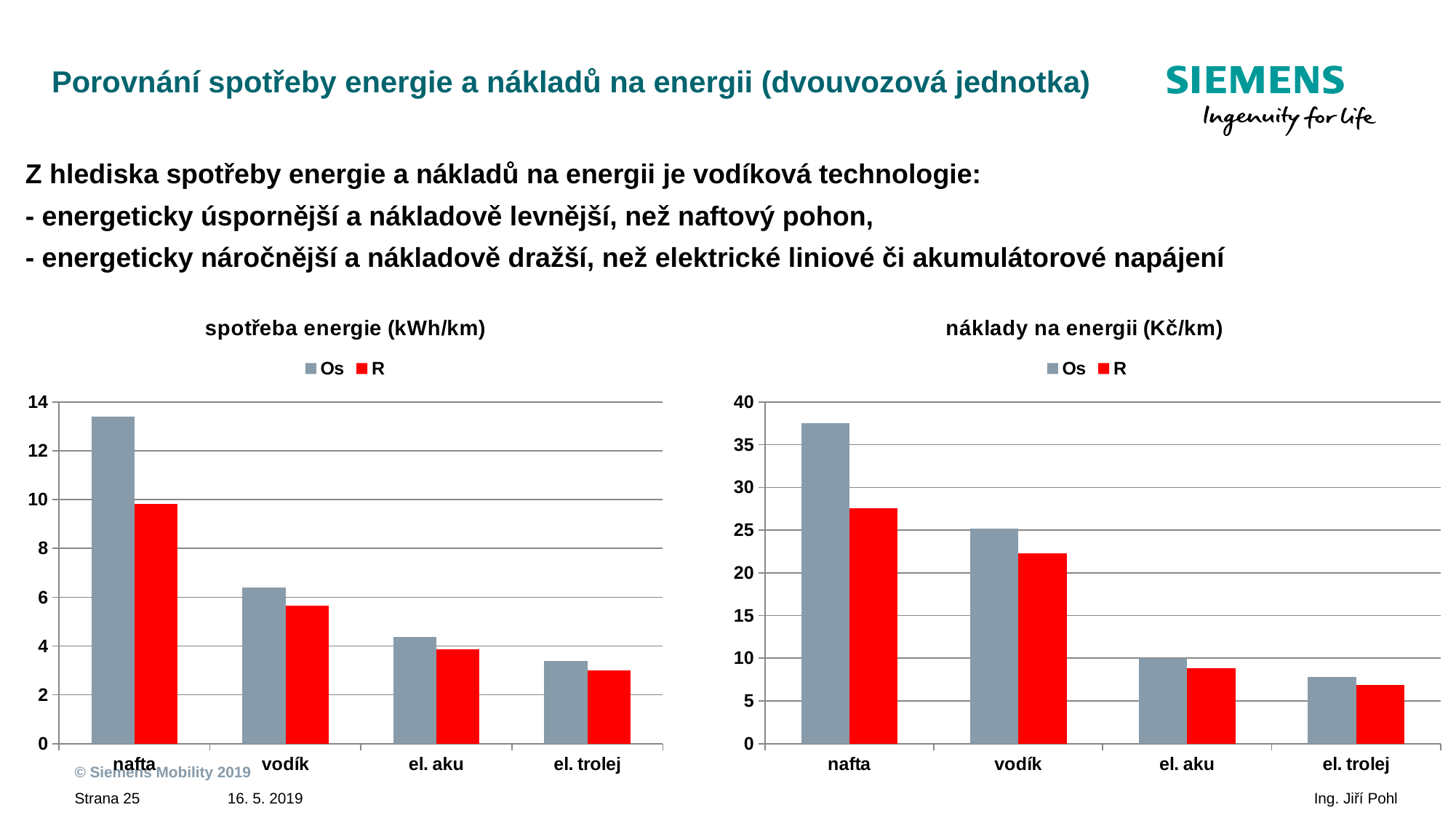
In the chart titled 'náklady na energii (Kč/km)', which category has the highest Os value? nafta In the chart titled 'spotřeba energie (kWh/km)', how many categories are shown on the x axis? 4 In the chart titled 'spotřeba energie (kWh/km)', which category has the highest Os value? nafta In the chart titled 'náklady na energii (Kč/km)', which category has the lowest R value? el. trolej What kind of chart is the chart titled 'náklady na energii (Kč/km)'? bar chart In the chart titled 'spotřeba energie (kWh/km)', is the Os value for nafta greater or less than 12? greater In the chart titled 'náklady na energii (Kč/km)', is the R value for vodík greater or less than 25? less In the chart titled 'spotřeba energie (kWh/km)', is the R value for vodík greater or less than 6? less In the chart titled 'náklady na energii (Kč/km)', how many series does the legend list? 2 In the chart titled 'spotřeba energie (kWh/km)', which is larger for vodík, the Os value or the R value? Os In the chart titled 'spotřeba energie (kWh/km)', which category has the lowest R value? el. trolej